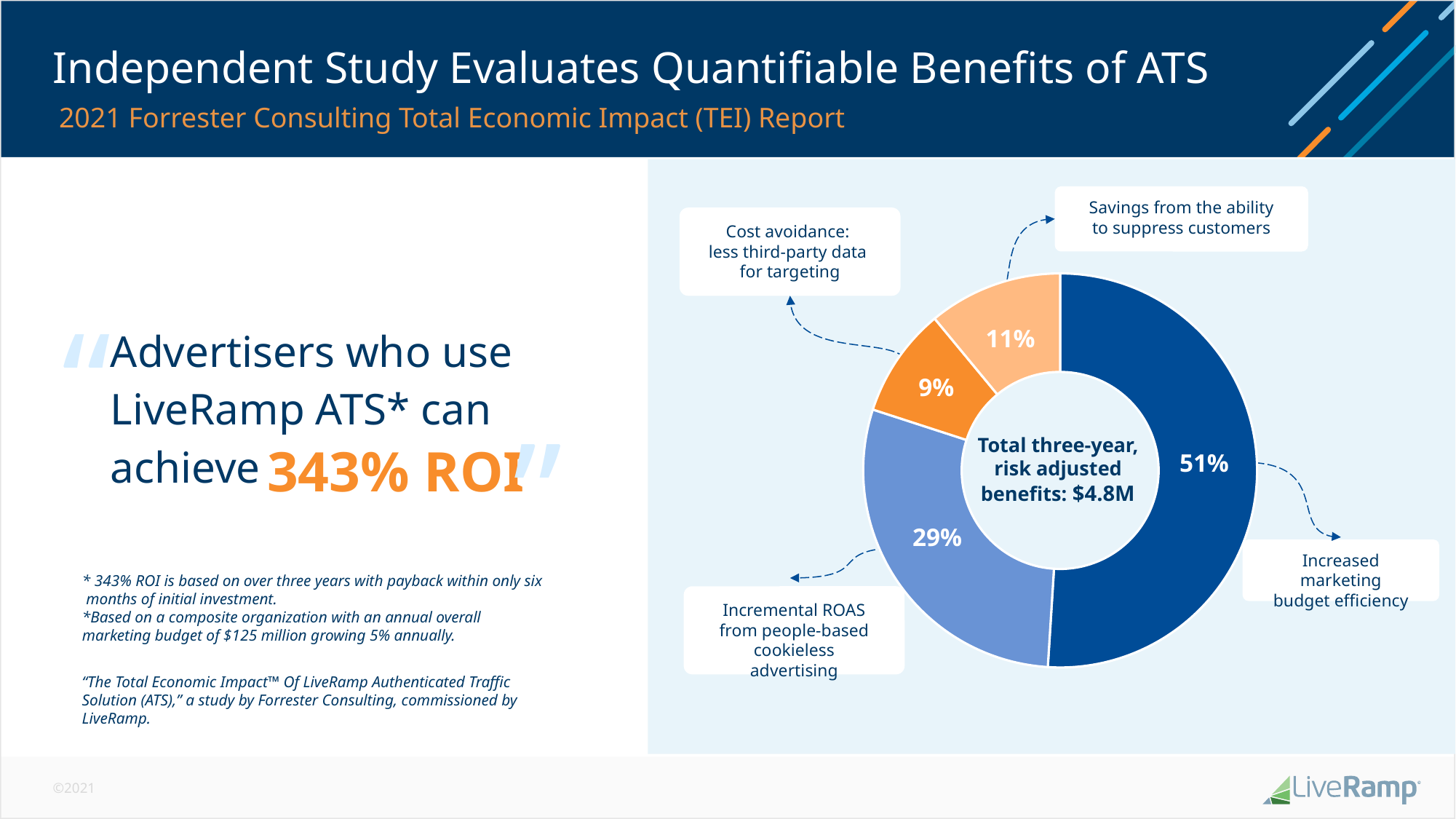
What share of the total three-year benefits comes from increased marketing budget efficiency? 51% Which benefit category has the largest share of the donut chart? Increased marketing budget efficiency What is the combined share of the two orange segments (cost avoidance and savings from suppressing customers)? 20% What type of chart is used to show the breakdown of benefits? Donut (pie) chart What percentage of the benefits comes from cost avoidance: less third-party data for targeting? 9% What total three-year, risk adjusted benefits value is shown in the centre of the donut chart? $4.8M What is the difference in percentage points between increased marketing budget efficiency and incremental ROAS from people-based cookieless advertising? 22 percentage points How many benefit categories are shown in the donut chart? 4 Which is larger: the share for savings from the ability to suppress customers or the share for cost avoidance? Savings from the ability to suppress customers What share of the benefits is attributed to incremental ROAS from people-based cookieless advertising? 29% What percentage of the benefits comes from savings from the ability to suppress customers? 11% Which benefit category has the smallest share of the donut chart? Cost avoidance: less third-party data for targeting